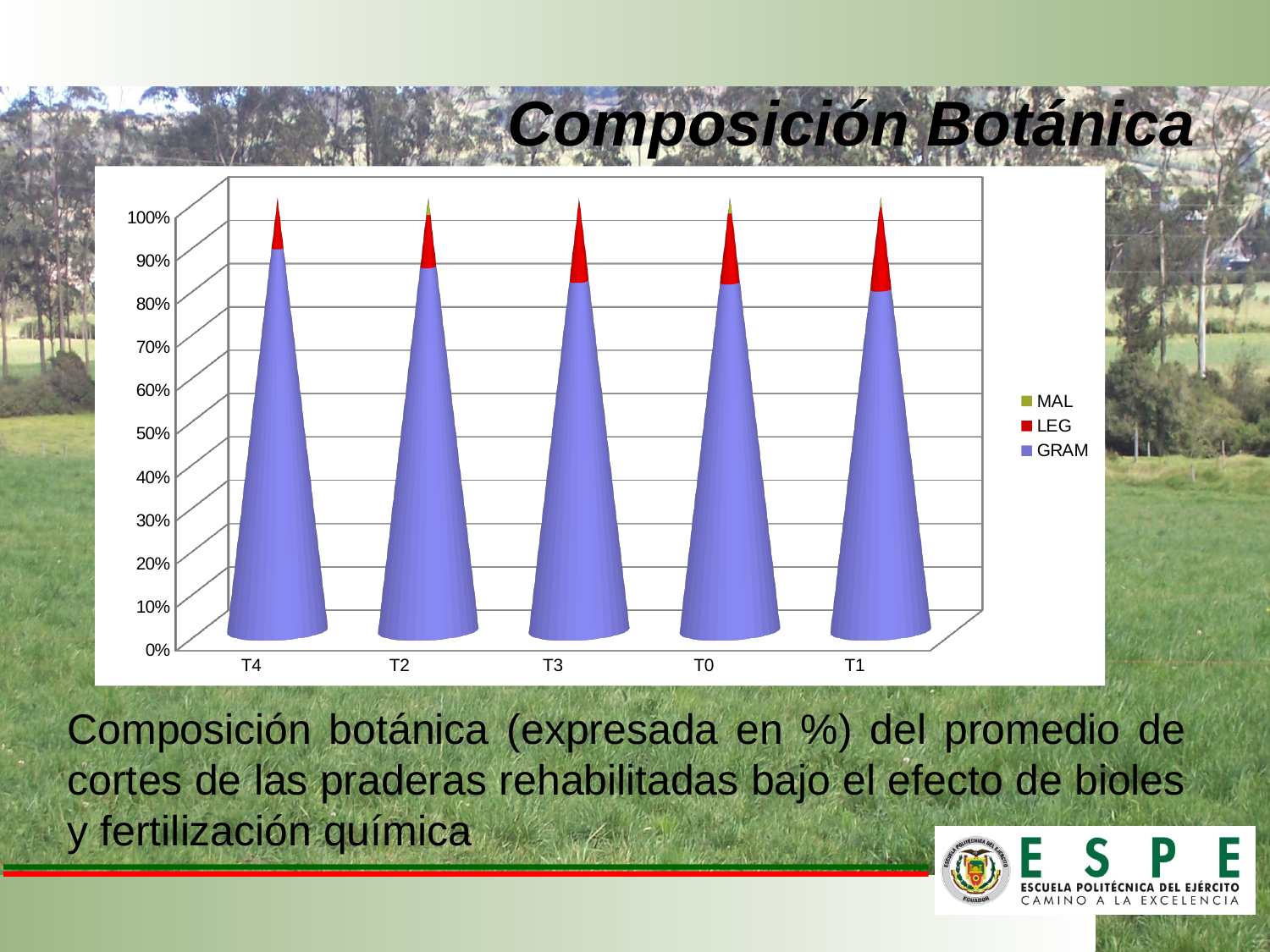
What kind of chart is shown on the slide? stacked bar chart Is the GRAM share for T2 greater or less than 80%? greater How many series does the chart's legend list? 3 How many categories are shown on the x axis of the chart? 5 Which series is shown in red in the chart? LEG Is the GRAM share for T2 greater or less than 90%? less Which has the larger GRAM share, T4 or T1? T4 What is the title of the chart? Composición Botánica Is the GRAM share for T3 greater or less than 90%? less Which has the larger LEG share, T1 or T4? T1 Which category has the highest GRAM share in the chart? T4